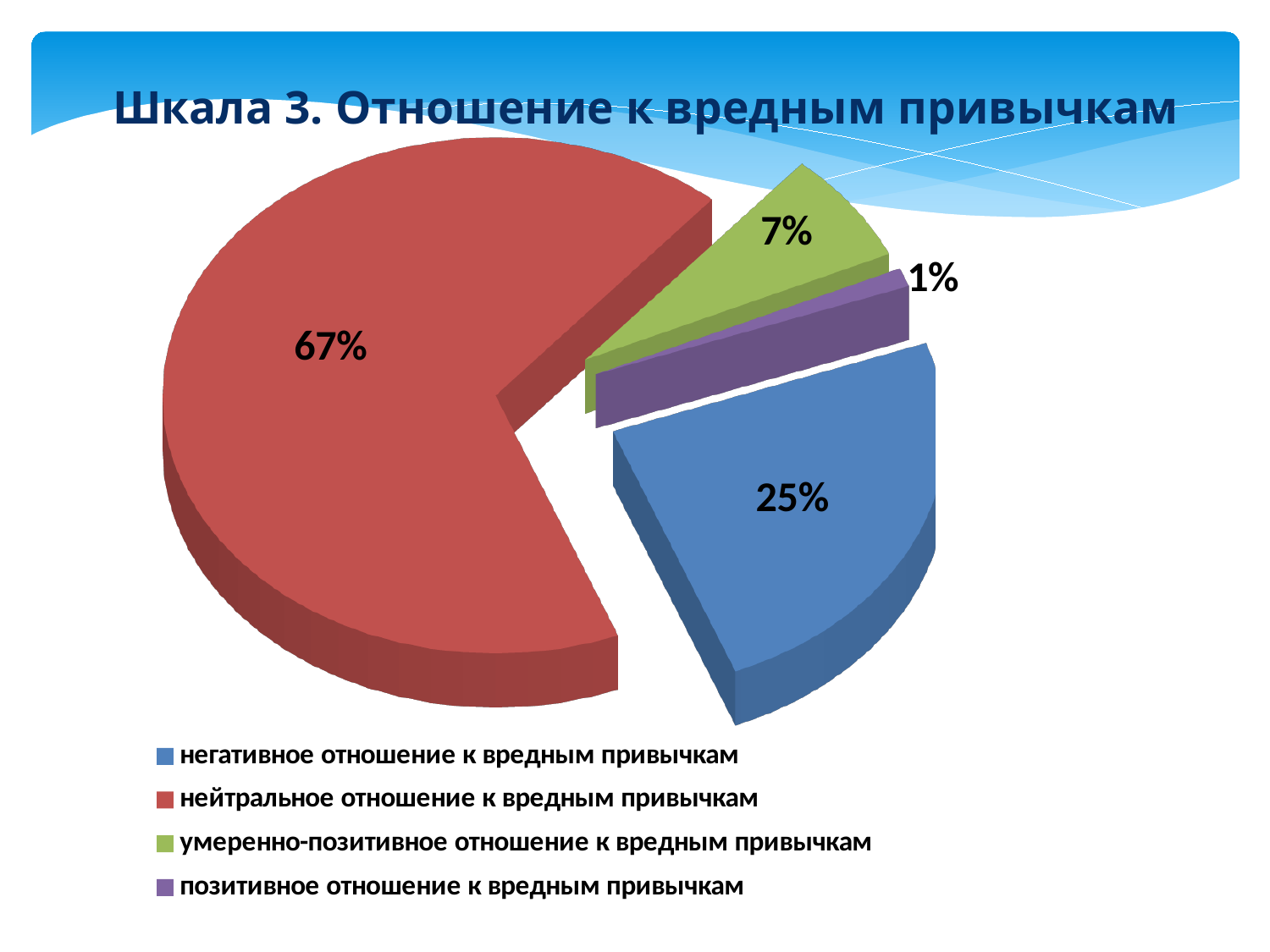
What share of the pie does 'позитивное отношение к вредным привычкам' have? 1% Which category has the largest slice of the pie? нейтральное отношение к вредным привычкам What share of the pie does 'нейтральное отношение к вредным привычкам' have? 67% What share of the pie does 'негативное отношение к вредным привычкам' have? 25% Which category has the smallest slice of the pie? позитивное отношение к вредным привычкам What kind of chart is shown on the slide? pie chart What colour is the slice for 'умеренно-позитивное отношение к вредным привычкам'? green What is the title of the chart on the slide? Шкала 3. Отношение к вредным привычкам What is the difference in percentage points between 'нейтральное отношение к вредным привычкам' and 'негативное отношение к вредным привычкам'? 42 How many categories does the pie chart show? 4 Which is larger: the share for 'негативное отношение к вредным привычкам' or for 'умеренно-позитивное отношение к вредным привычкам'? негативное отношение к вредным привычкам